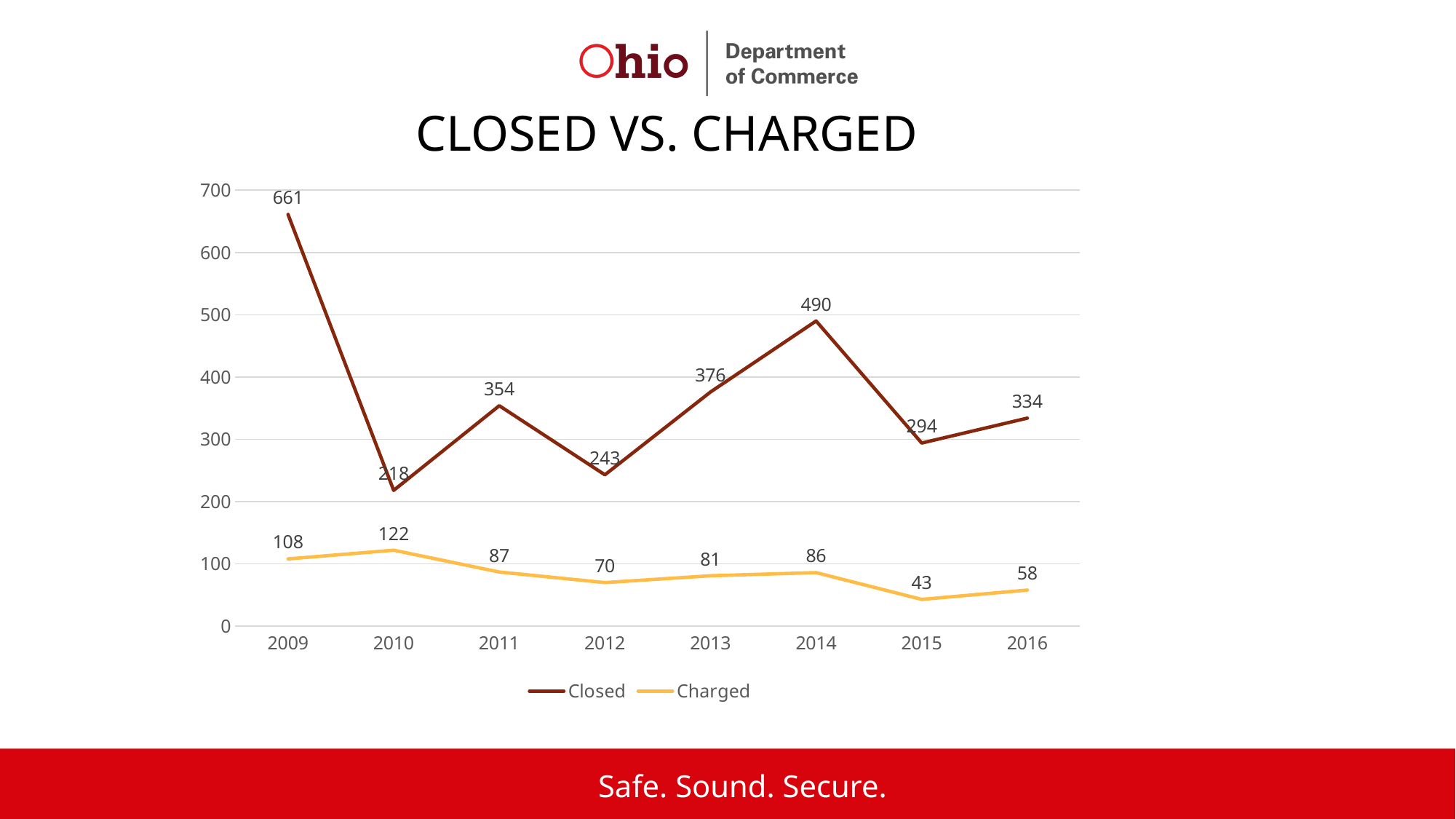
How many series does the legend list? 2 Which year has the lowest Closed value? 2010 How many years are shown on the x axis? 8 Which year has the lowest Charged value? 2015 Which year has the highest Closed value? 2009 What is the Closed value for 2009? 661 What is the Closed value for 2014? 490 What is the title of the chart? CLOSED VS. CHARGED What is the Charged value for 2015? 43 What kind of chart is shown on the slide? Line chart What is the difference between the Closed and Charged values in 2016? 276 Is the Closed value for 2011 larger than the Closed value for 2012? Yes